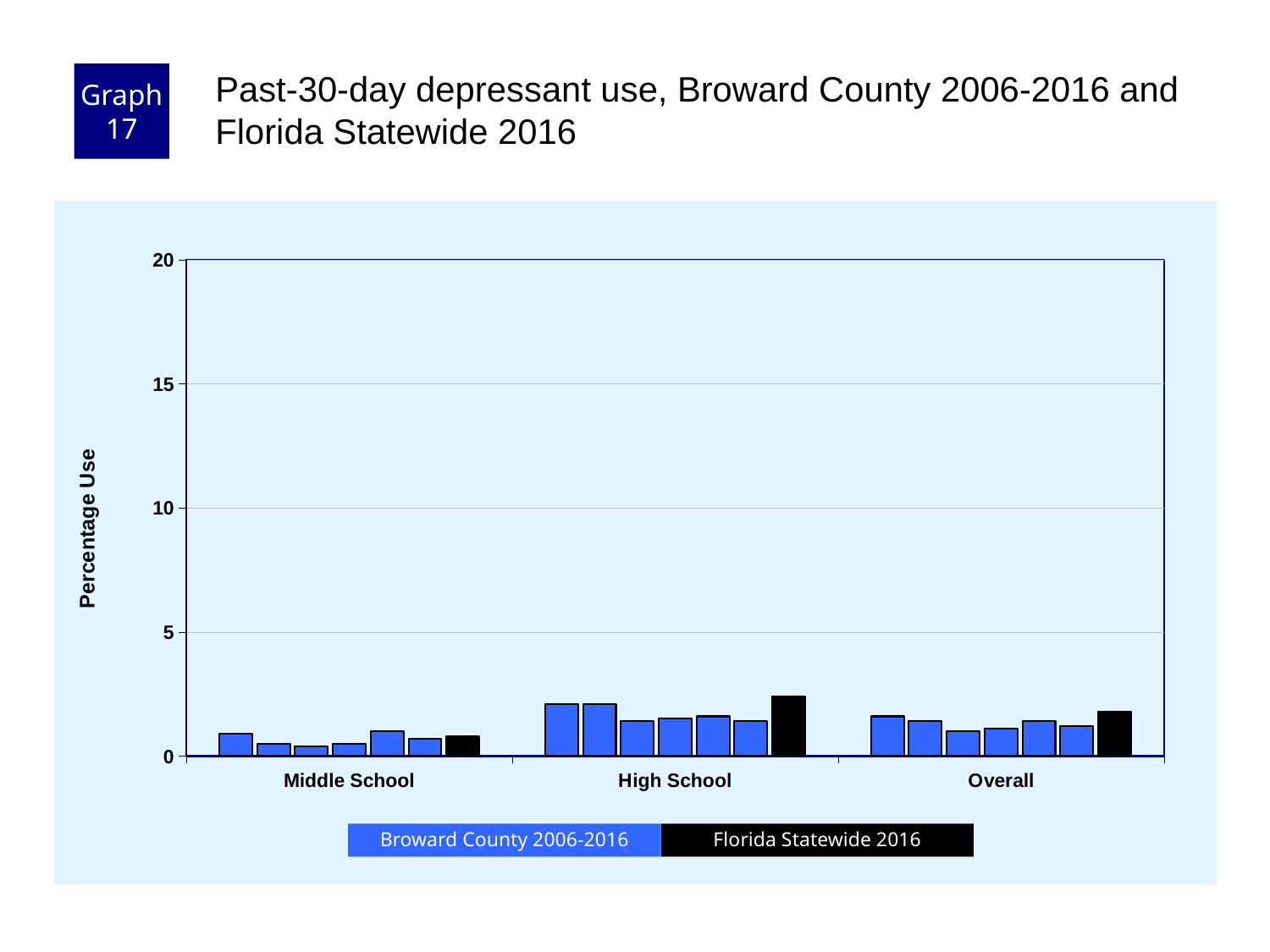
Which is larger, the Florida Statewide 2016 value for Overall or for Middle School? Overall Is the Florida Statewide 2016 value for Overall greater or less than 10? less Which is larger, the Florida Statewide 2016 value for High School or for Middle School? High School Is the Florida Statewide 2016 value for High School greater or less than 5? less What is the label on the y axis of the chart? Percentage Use What kind of chart is shown on the slide? bar chart Which colour represents Florida Statewide 2016 in the chart's legend? black How many series does the chart's legend list? 2 Is the Florida Statewide 2016 value for Middle School greater or less than 5? less How many categories are shown on the x axis of the chart? 3 Which category has the lowest Florida Statewide 2016 value? Middle School Which category has the highest Florida Statewide 2016 value? High School